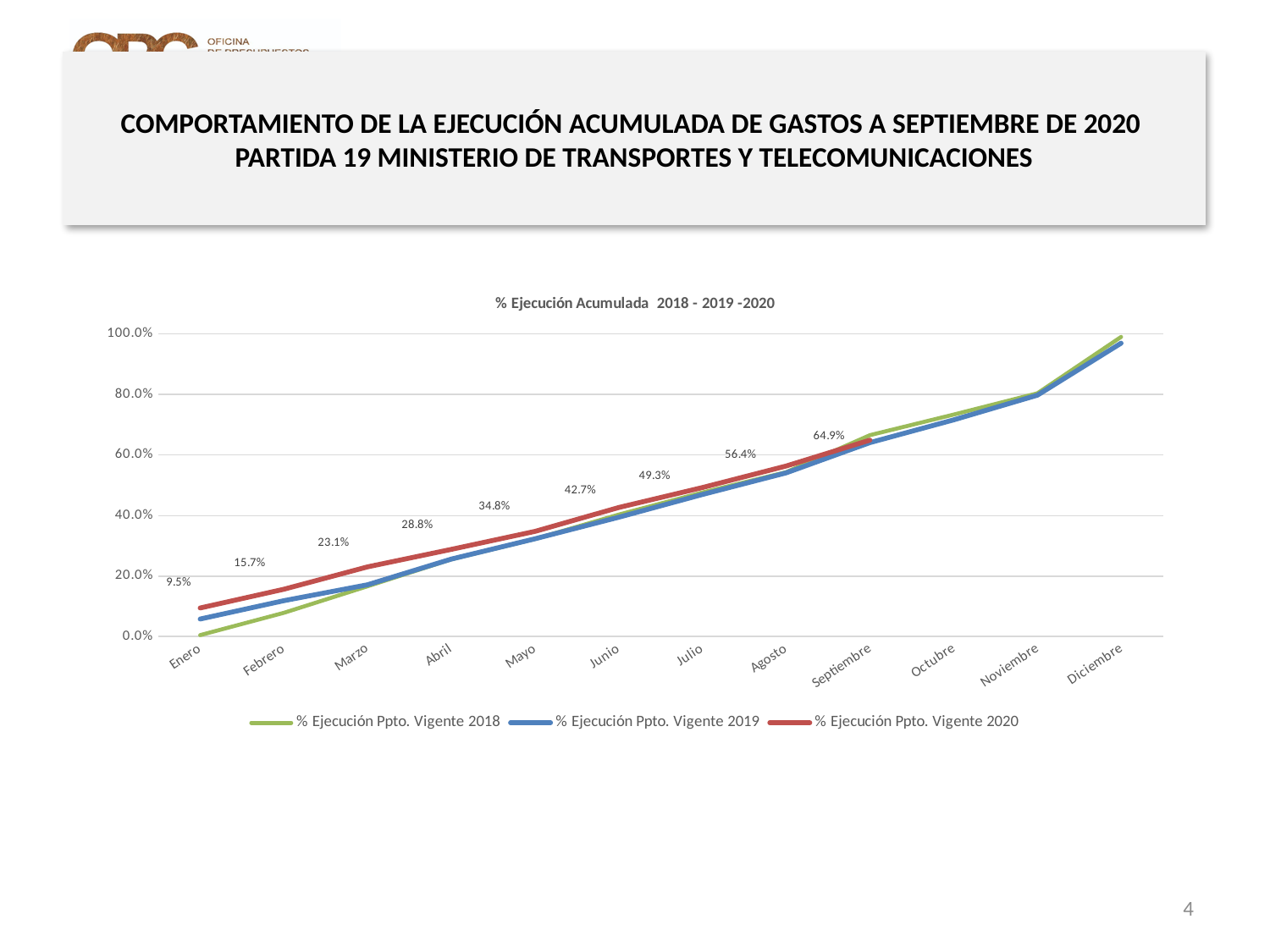
What is the title of the chart? % Ejecución Acumulada 2018 - 2019 -2020 What is the value for % Ejecución Ppto. Vigente 2020 in Enero? 9.5% What is the difference between the % Ejecución Ppto. Vigente 2020 values for Mayo and Abril? 6.0% What is the value for % Ejecución Ppto. Vigente 2020 in Septiembre? 64.9% What is the value for % Ejecución Ppto. Vigente 2020 in Marzo? 23.1% Does the % Ejecución Ppto. Vigente 2020 series rise or fall from Enero to Septiembre? rise How many months are shown on the x axis? 12 Is the value for % Ejecución Ppto. Vigente 2018 in Enero greater or less than 20.0%? less What is the value for % Ejecución Ppto. Vigente 2020 in Junio? 42.7% What is the difference between the % Ejecución Ppto. Vigente 2020 values for Septiembre and Agosto? 8.5% What kind of chart is shown on the slide? line chart How many series does the legend list? 3